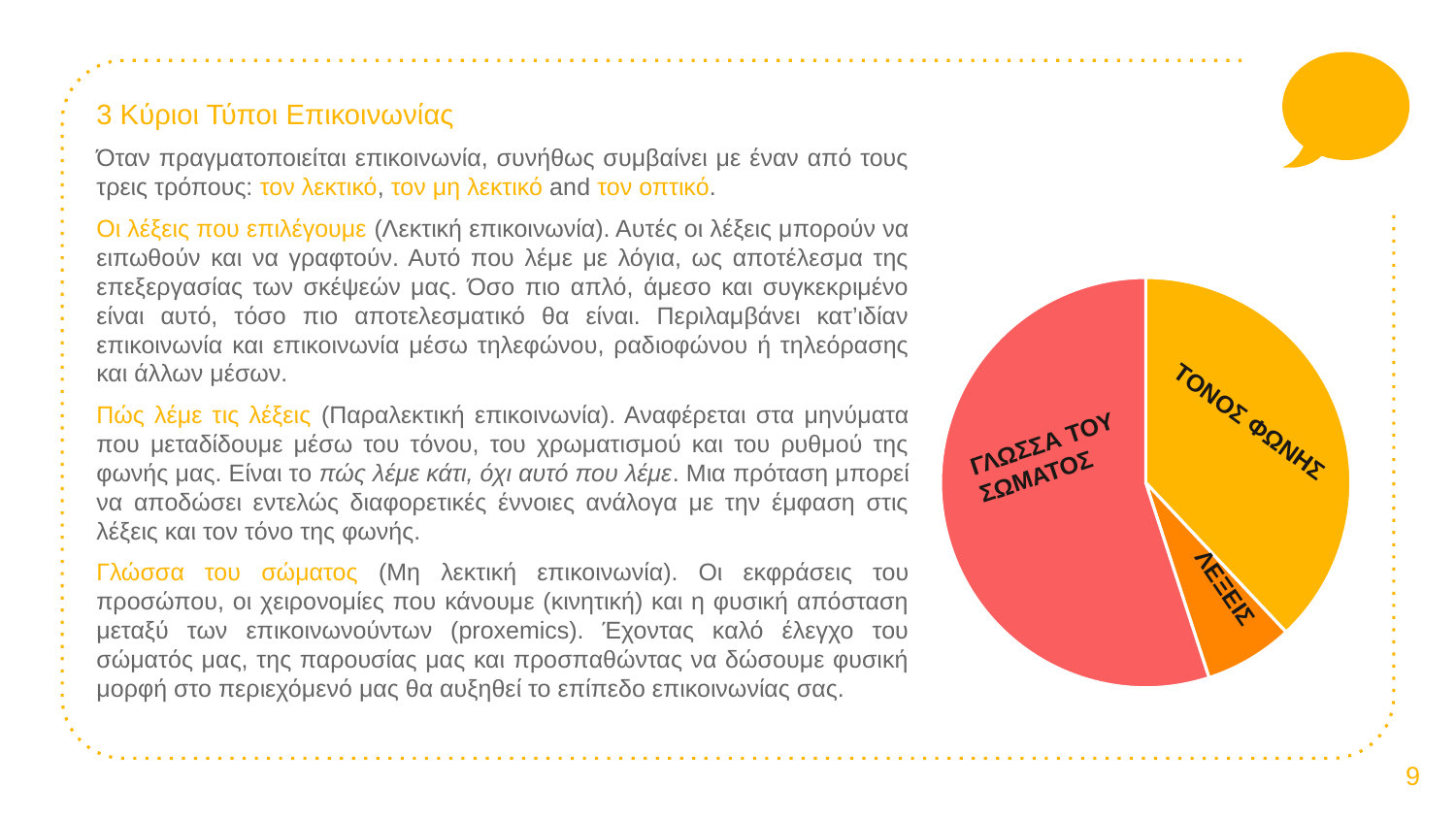
Which slice of the pie chart is the largest? ΓΛΩΣΣΑ ΤΟΥ ΣΩΜΑΤΟΣ How many slices does the pie chart have? 3 What kind of chart is shown on the slide? pie chart Which slice is larger in the pie chart, ΛΕΞΕΙΣ or ΓΛΩΣΣΑ ΤΟΥ ΣΩΜΑΤΟΣ? ΓΛΩΣΣΑ ΤΟΥ ΣΩΜΑΤΟΣ Which slice is larger in the pie chart, ΓΛΩΣΣΑ ΤΟΥ ΣΩΜΑΤΟΣ or ΤΟΝΟΣ ΦΩΝΗΣ? ΓΛΩΣΣΑ ΤΟΥ ΣΩΜΑΤΟΣ Which slice is larger in the pie chart, ΤΟΝΟΣ ΦΩΝΗΣ or ΛΕΞΕΙΣ? ΤΟΝΟΣ ΦΩΝΗΣ Which slice of the pie chart is coloured yellow? ΤΟΝΟΣ ΦΩΝΗΣ Which slice of the pie chart is the smallest? ΛΕΞΕΙΣ What colour is the ΓΛΩΣΣΑ ΤΟΥ ΣΩΜΑΤΟΣ slice of the pie chart? red